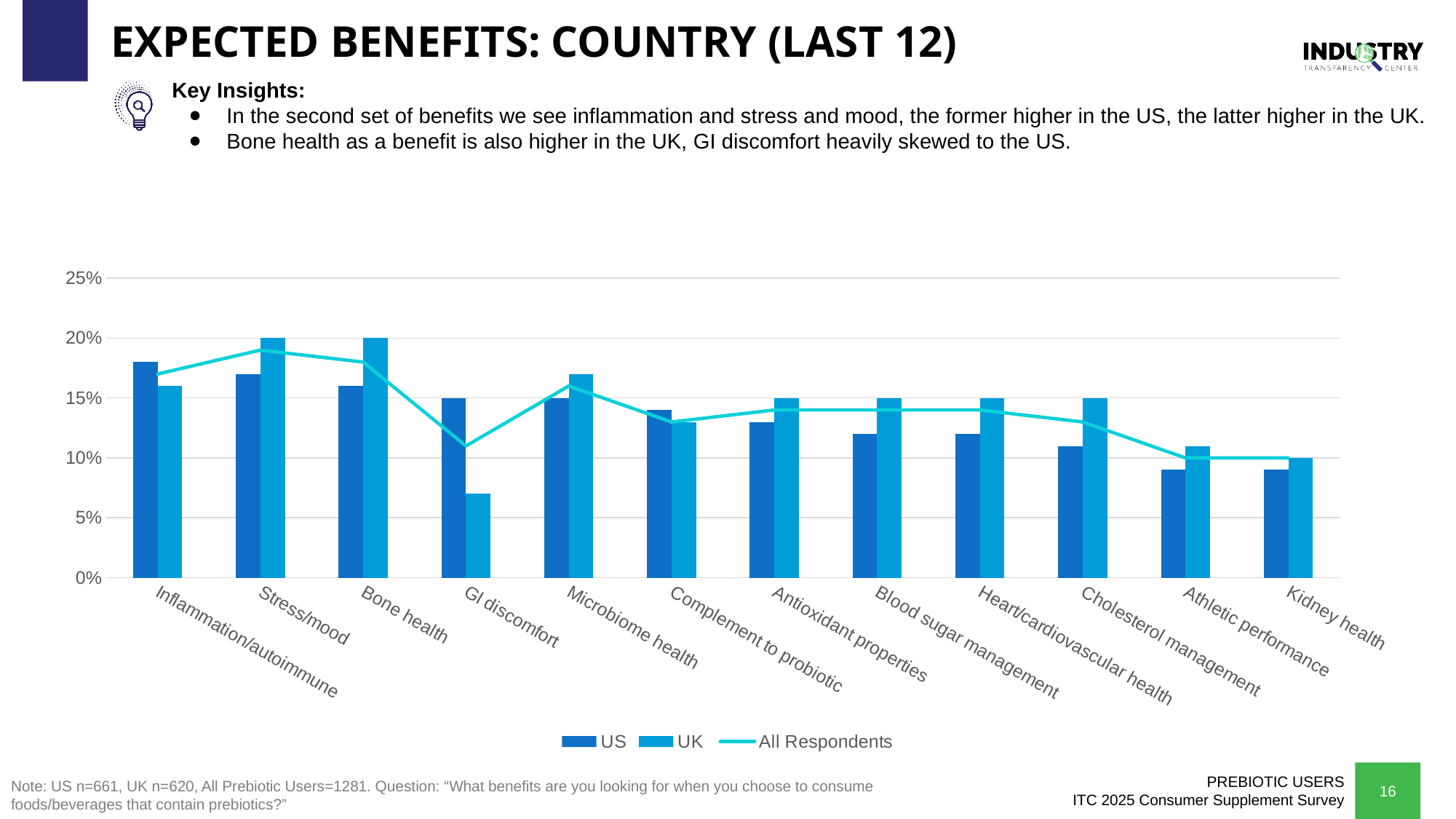
What kind of chart is shown on the slide? combination bar and line chart Which country has the larger value for Bone health, US or UK? UK What is the UK value for Bone health? 20% What is the UK value for Stress/mood? 20% Is the US value for Inflammation/autoimmune greater or less than 15%? greater Which category has the lowest UK value? GI discomfort How many series does the legend list? 3 How many benefit categories are shown on the x axis? 12 Which country has the larger value for GI discomfort, US or UK? US Is the UK value for GI discomfort greater or less than 10%? less What is the UK value for Kidney health? 10% What is the US value for GI discomfort? 15%